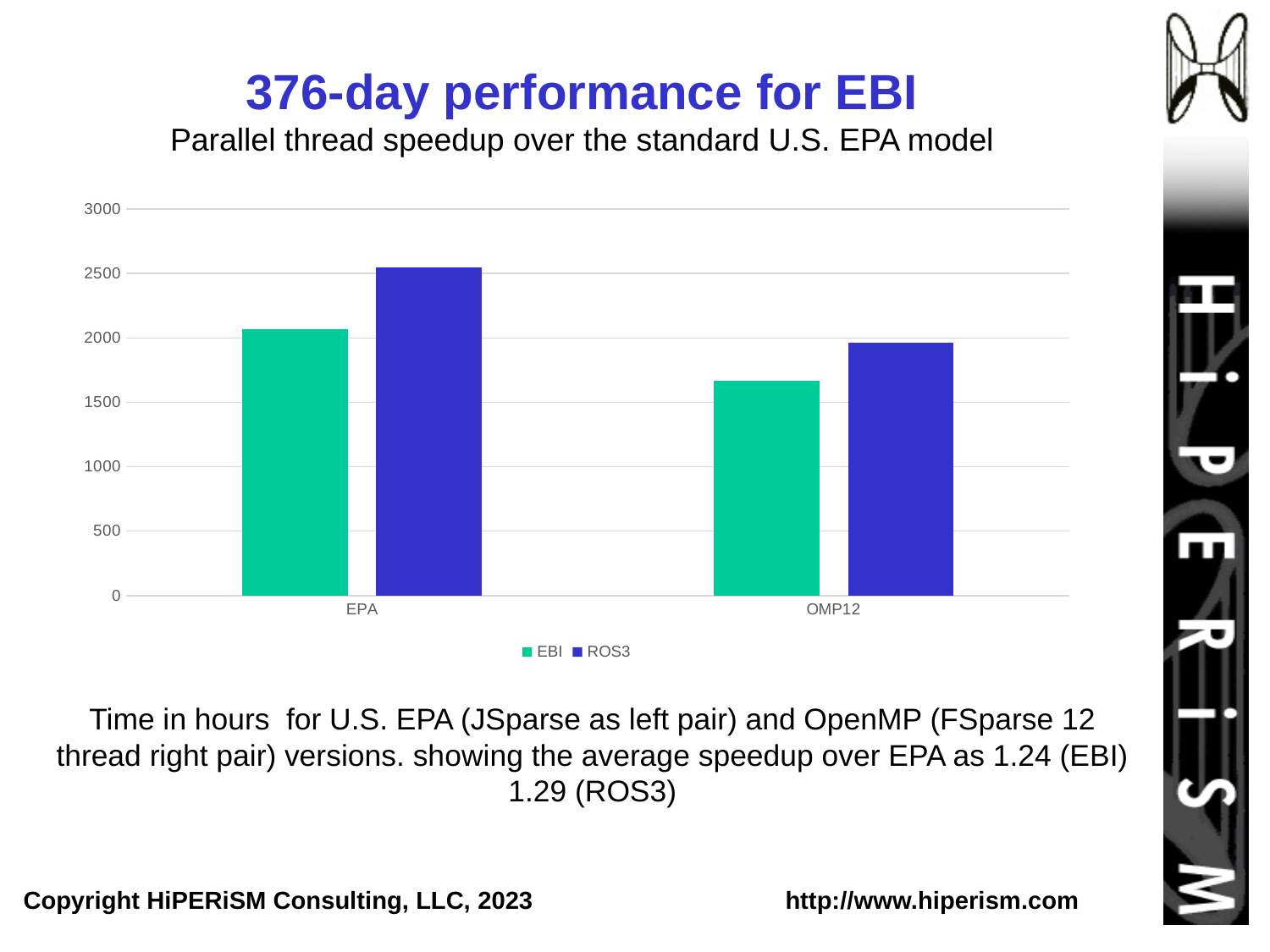
How many series does the legend list? 2 How many categories are shown on the x axis? 2 Is the ROS3 value for EPA greater or less than 2500? greater Which category has the tallest bar overall? EPA Is the EBI value for OMP12 greater or less than 2000? less Is the ROS3 value for OMP12 greater or less than 2000? less What kind of chart is shown on the slide? bar chart For OMP12, which series has the larger value, EBI or ROS3? ROS3 What are the two series named in the legend? EBI and ROS3 Which series has the lowest bar in the chart? EBI Do the EBI values rise or fall from EPA to OMP12? fall